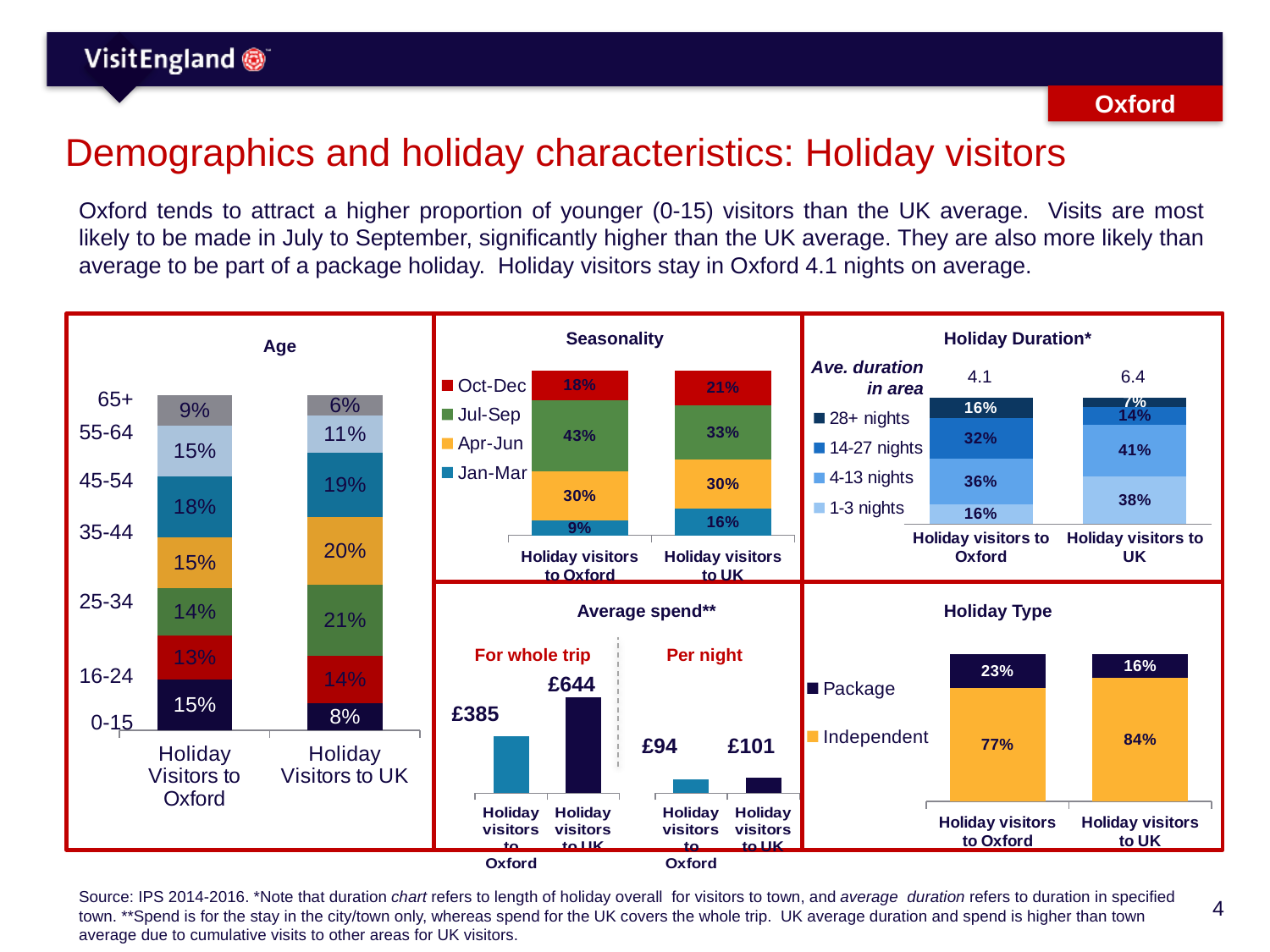
In the Average spend chart, which is larger: the per night spend for holiday visitors to Oxford or for holiday visitors to the UK? Holiday visitors to UK In the Holiday Type chart, what percentage of holiday visitors to Oxford are on a package holiday? 23% In the Age chart, what percentage of holiday visitors to Oxford are aged 0-15? 15% In the Holiday Duration chart, what is the average duration in area for holiday visitors to Oxford? 4.1 In the Seasonality chart, which quarter has the lowest share for holiday visitors to Oxford? Jan-Mar In the Holiday Duration chart, what percentage of holiday visitors to the UK stay 1-3 nights? 38% In the Holiday Duration chart, how many series does the legend list? 4 In the Seasonality chart, what share of holiday visits to Oxford are made in Jul-Sep? 43% What kind of chart is the Holiday Type chart? Stacked bar chart In the Seasonality chart, what is the difference between the Jul-Sep share for holiday visitors to Oxford and for holiday visitors to the UK? 10% In the Age chart, what percentage of holiday visitors to the UK are aged 25-34? 21% In the Average spend chart, what is the spend for the whole trip for holiday visitors to Oxford? £385